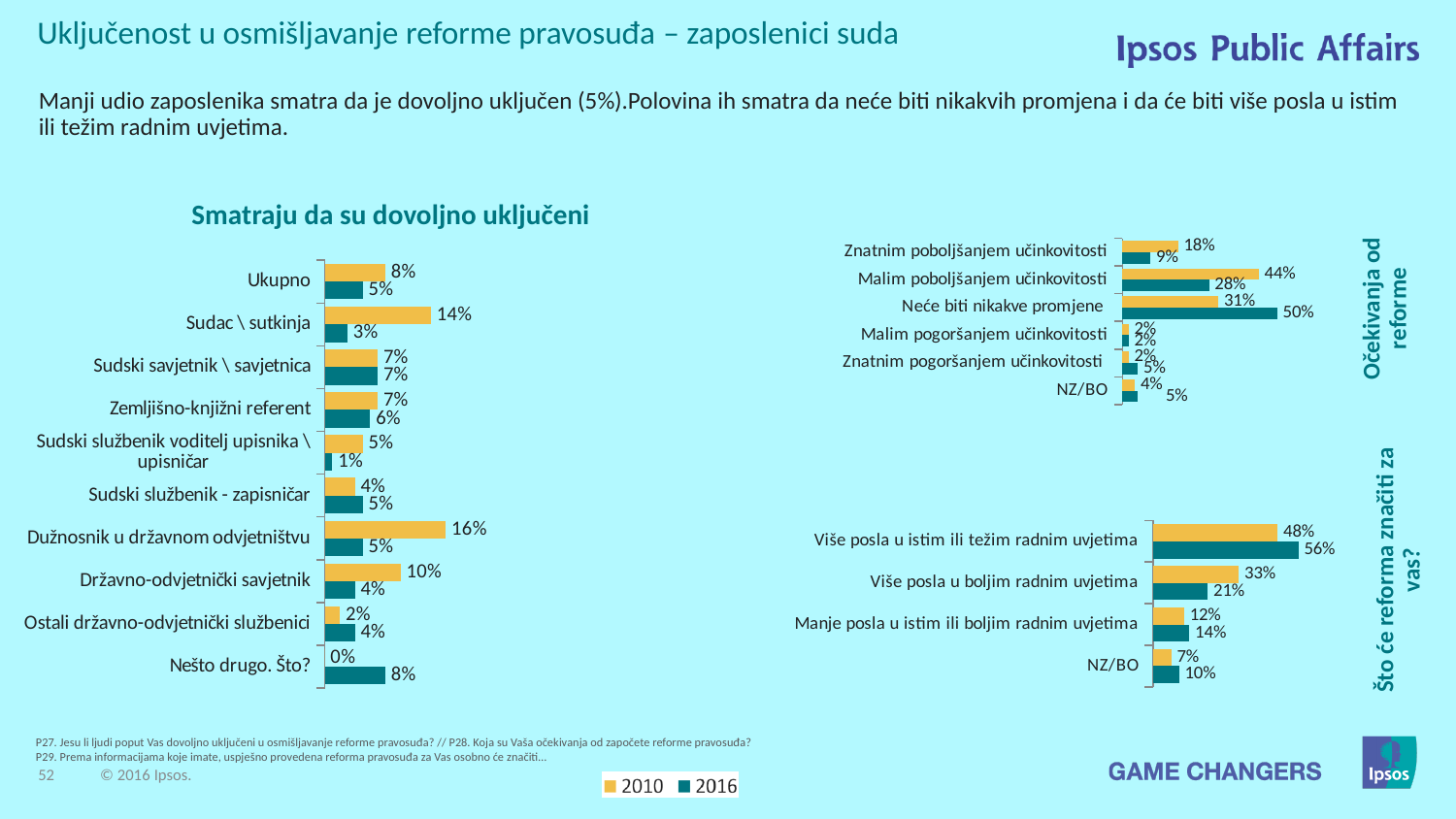
In the chart 'Smatraju da su dovoljno uključeni', which category has the lowest 2016 value? Sudski službenik voditelj upisnika \ upisničar In the chart 'Što će reforma značiti za vas?', what is the 2016 value for Više posla u istim ili težim radnim uvjetima? 56% How many series does the legend list, and what are they? 2: 2010 and 2016 In the chart 'Očekivanja od reforme', is the 2010 value for Malim poboljšanjem učinkovitosti larger or smaller than the 2016 value? larger In the chart 'Očekivanja od reforme', which category has the highest 2010 value? Malim poboljšanjem učinkovitosti In the chart 'Smatraju da su dovoljno uključeni', what is the 2010 value for Sudac \ sutkinja? 14% In the chart 'Smatraju da su dovoljno uključeni', what is the 2016 value for Ukupno? 5% In the chart 'Smatraju da su dovoljno uključeni', how many categories are shown? 10 In the chart 'Očekivanja od reforme', what is the 2016 value for Neće biti nikakve promjene? 50% In the chart 'Smatraju da su dovoljno uključeni', which category has the highest 2010 value? Dužnosnik u državnom odvjetništvu In the chart 'Smatraju da su dovoljno uključeni', what is the difference between the 2010 and 2016 values for Sudac \ sutkinja? 11 percentage points In the chart 'Što će reforma značiti za vas?', what is the difference between the 2010 and 2016 values for Više posla u boljim radnim uvjetima? 12 percentage points